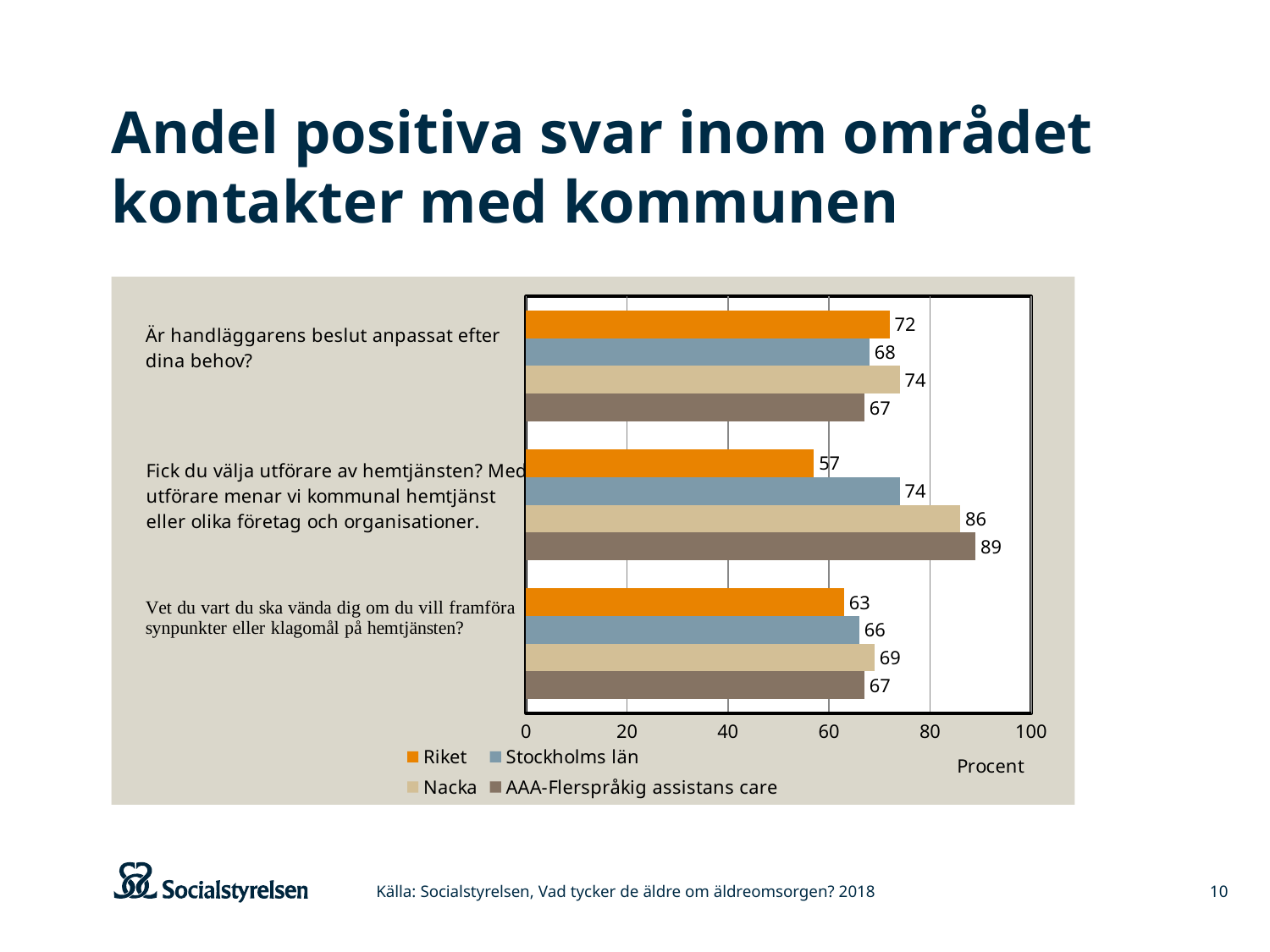
What is the value for AAA-Flerspråkig assistans care on the question "Fick du välja utförare av hemtjänsten?"? 89 Is the value for Riket on the question "Fick du välja utförare av hemtjänsten?" greater or less than 60? less What is the difference between Nacka and Riket on the question "Fick du välja utförare av hemtjänsten?"? 29 Which series has the highest value on the question "Fick du välja utförare av hemtjänsten?"? AAA-Flerspråkig assistans care What is the value for Riket on the question "Är handläggarens beslut anpassat efter dina behov?"? 72 Which is larger on the question "Är handläggarens beslut anpassat efter dina behov?": Nacka or Stockholms län? Nacka What kind of chart is shown on the slide? Bar chart Which series has the lowest value on the question "Fick du välja utförare av hemtjänsten?"? Riket What unit is shown on the horizontal axis of the chart? Procent How many series does the legend list? 4 What is the value for Nacka on the question "Vet du vart du ska vända dig om du vill framföra synpunkter eller klagomål på hemtjänsten?"? 69 How many questions (categories) are shown in the chart? 3